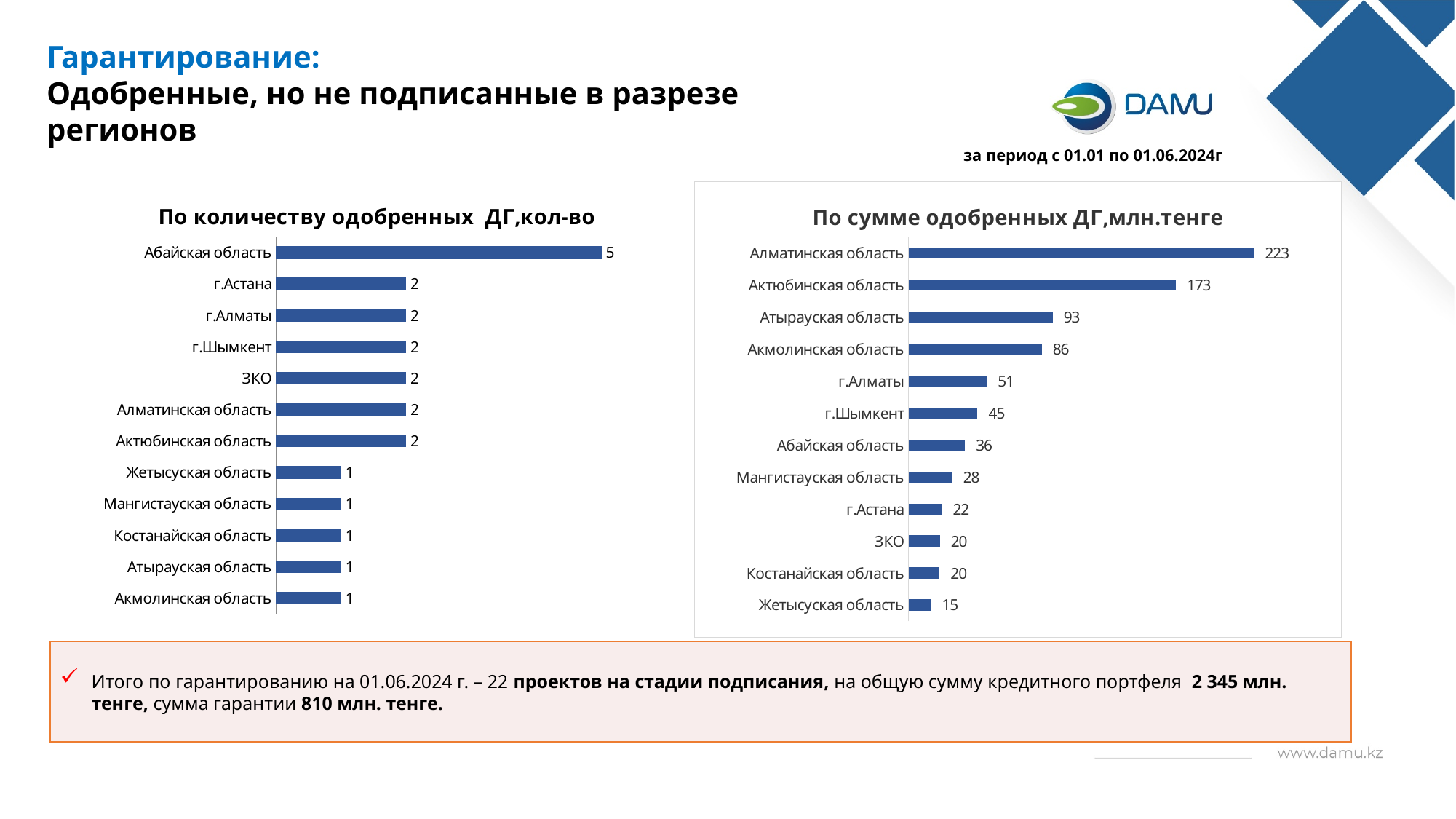
In the chart 'По сумме одобренных ДГ,млн.тенге', which region has the lowest value? Жетысуская область In the chart 'По сумме одобренных ДГ,млн.тенге', what is the difference between Алматинская область and Актюбинская область? 50 What is the title of the chart on the right side of the slide? По сумме одобренных ДГ,млн.тенге In the chart 'По сумме одобренных ДГ,млн.тенге', what is the value for Актюбинская область? 173 In the chart 'По количеству одобренных ДГ,кол-во', what is the difference between Абайская область and г.Астана? 3 In the chart 'По сумме одобренных ДГ,млн.тенге', which is larger: Атырауская область or Акмолинская область? Атырауская область What type of chart is 'По количеству одобренных ДГ,кол-во'? Bar chart In the chart 'По количеству одобренных ДГ,кол-во', what is the value for Абайская область? 5 How many regions are shown in the chart 'По сумме одобренных ДГ,млн.тенге'? 12 In the chart 'По сумме одобренных ДГ,млн.тенге', what is the value for г.Шымкент? 45 In the chart 'По количеству одобренных ДГ,кол-во', which region has the highest value? Абайская область In the chart 'По сумме одобренных ДГ,млн.тенге', which region has the highest value? Алматинская область